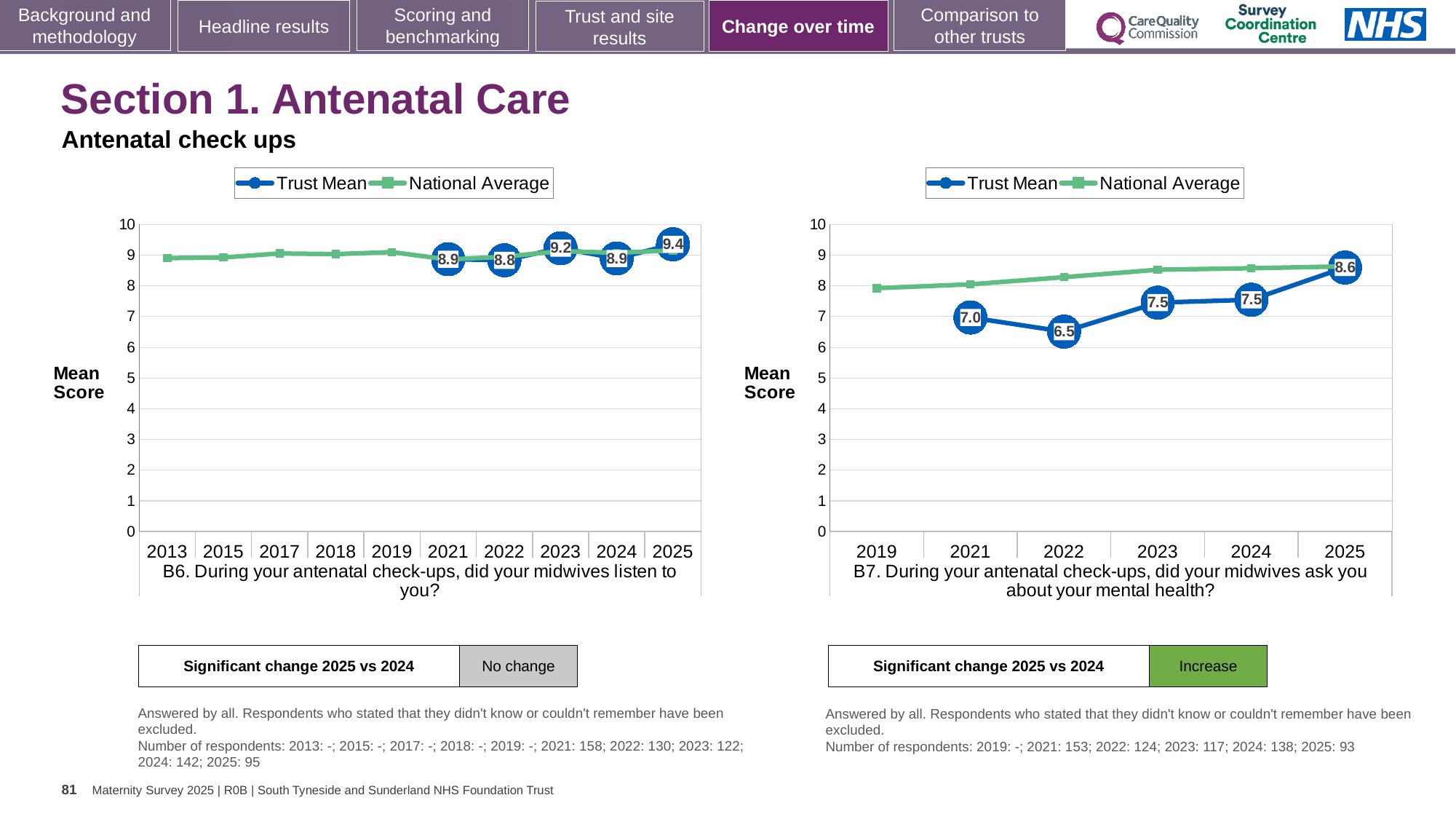
What kind of chart is the B6 chart (left)? Line chart In the B7 chart (right), which year has the lowest Trust Mean score? 2022 In the B6 chart (left), which year has the highest Trust Mean score? 2025 In the B7 chart (right), is the National Average value for 2019 greater or less than 7? greater In the B7 chart (right), what is the difference between the Trust Mean scores for 2025 and 2024? 1.1 In the B6 chart (left), what is the Trust Mean score for 2025? 9.4 In the B7 chart (right), does the Trust Mean rise or fall from 2022 to 2025? Rise In the B6 chart (left), what is the Trust Mean score for 2022? 8.8 In the B6 chart (left), which is larger, the Trust Mean for 2023 or for 2024? 2023 In the B7 chart (right), what is the Trust Mean score for 2022? 6.5 How many series does the legend of the B7 chart (right) list? 2 In the B7 chart (right), what is the Trust Mean score for 2025? 8.6